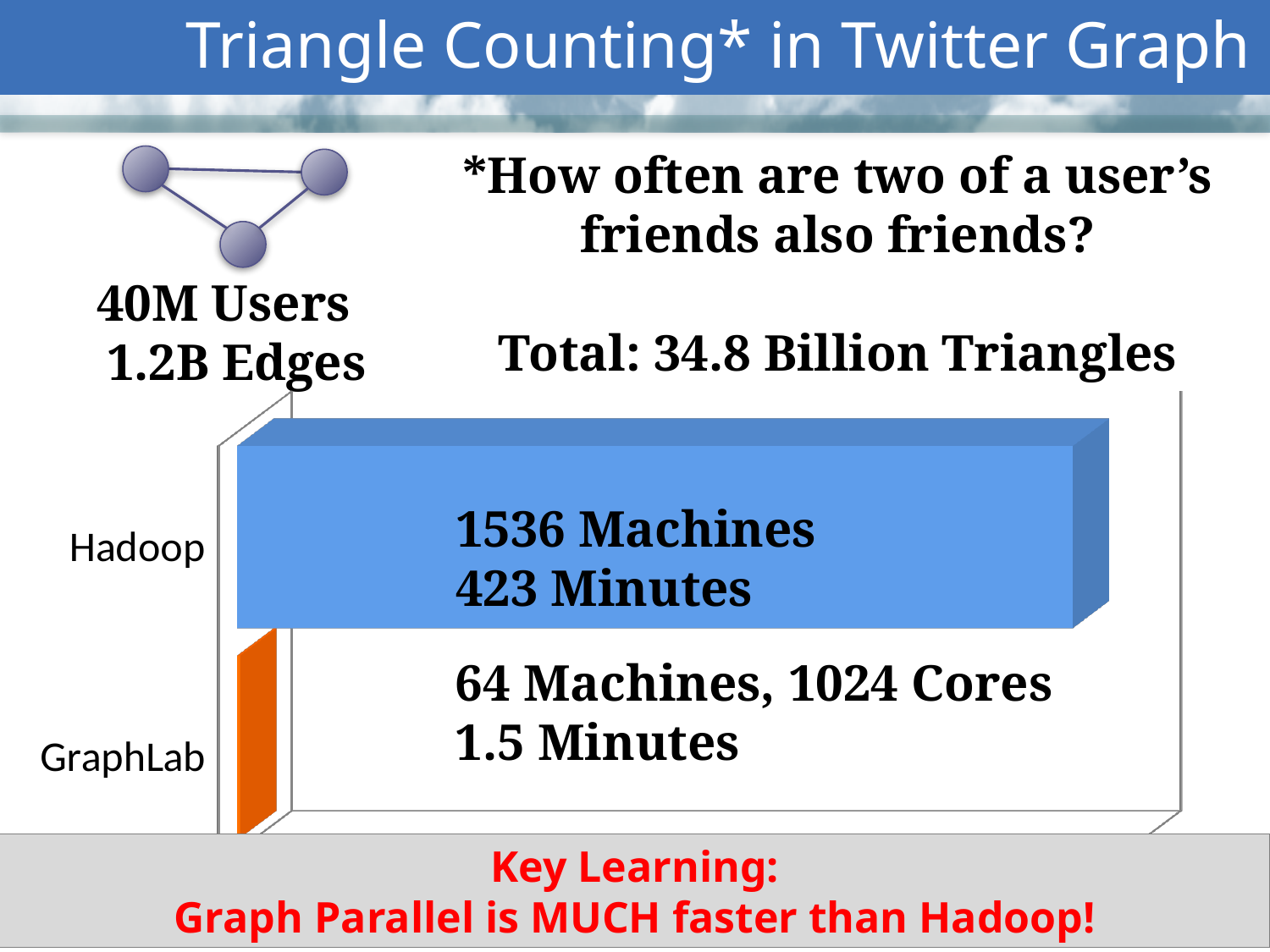
How many minutes did Hadoop take according to the chart? 423 Minutes Which category has the shortest bar in the chart? GraphLab How many cores did GraphLab use according to the chart? 1024 Cores How many minutes did GraphLab take according to the chart? 1.5 Minutes How many categories does the bar chart show? 2 What kind of chart is shown on the slide? bar chart Which category has the longest bar in the chart? Hadoop How many machines did GraphLab use according to the chart? 64 Machines How many machines did Hadoop use according to the chart? 1536 Machines What colour is the Hadoop bar in the chart? blue Which took more minutes, Hadoop or GraphLab? Hadoop What is the difference in minutes between Hadoop and GraphLab? 421.5 Minutes